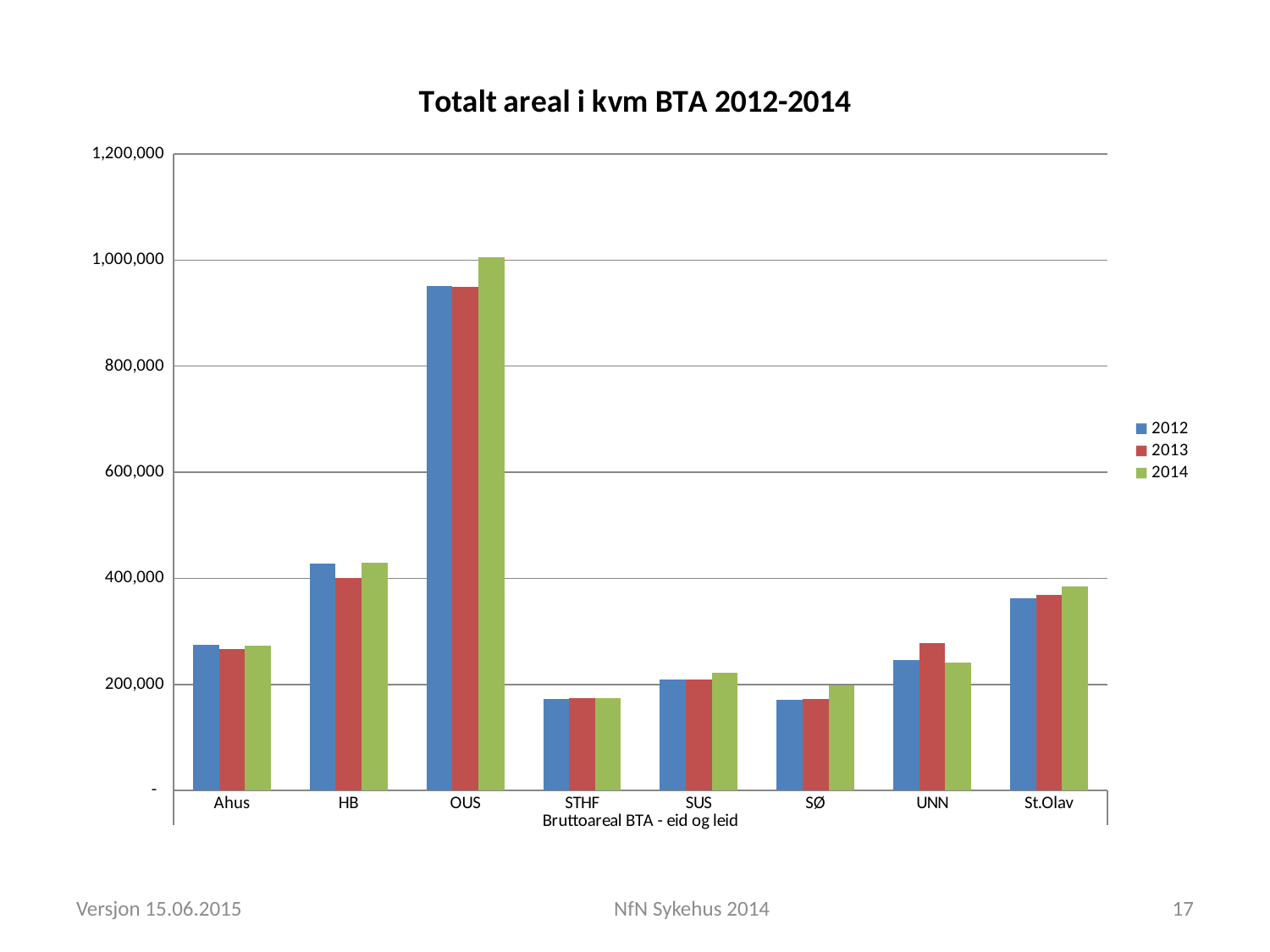
Is the value for OUS in 2012 greater or less than 1,000,000? less How many categories are shown on the x axis? 8 How many series does the legend list? 3 Which is larger for UNN: the 2012 value or the 2013 value? 2013 Which is larger for HB: the 2012 value or the 2013 value? 2012 What is the title of the chart? Totalt areal i kvm BTA 2012-2014 What kind of chart is shown on the slide? bar chart Which category has the lowest value in 2014? STHF Which category has the highest value in 2014? OUS Is the value for St.Olav in 2014 greater or less than 400,000? less Is the value for HB in 2012 greater or less than 400,000? greater